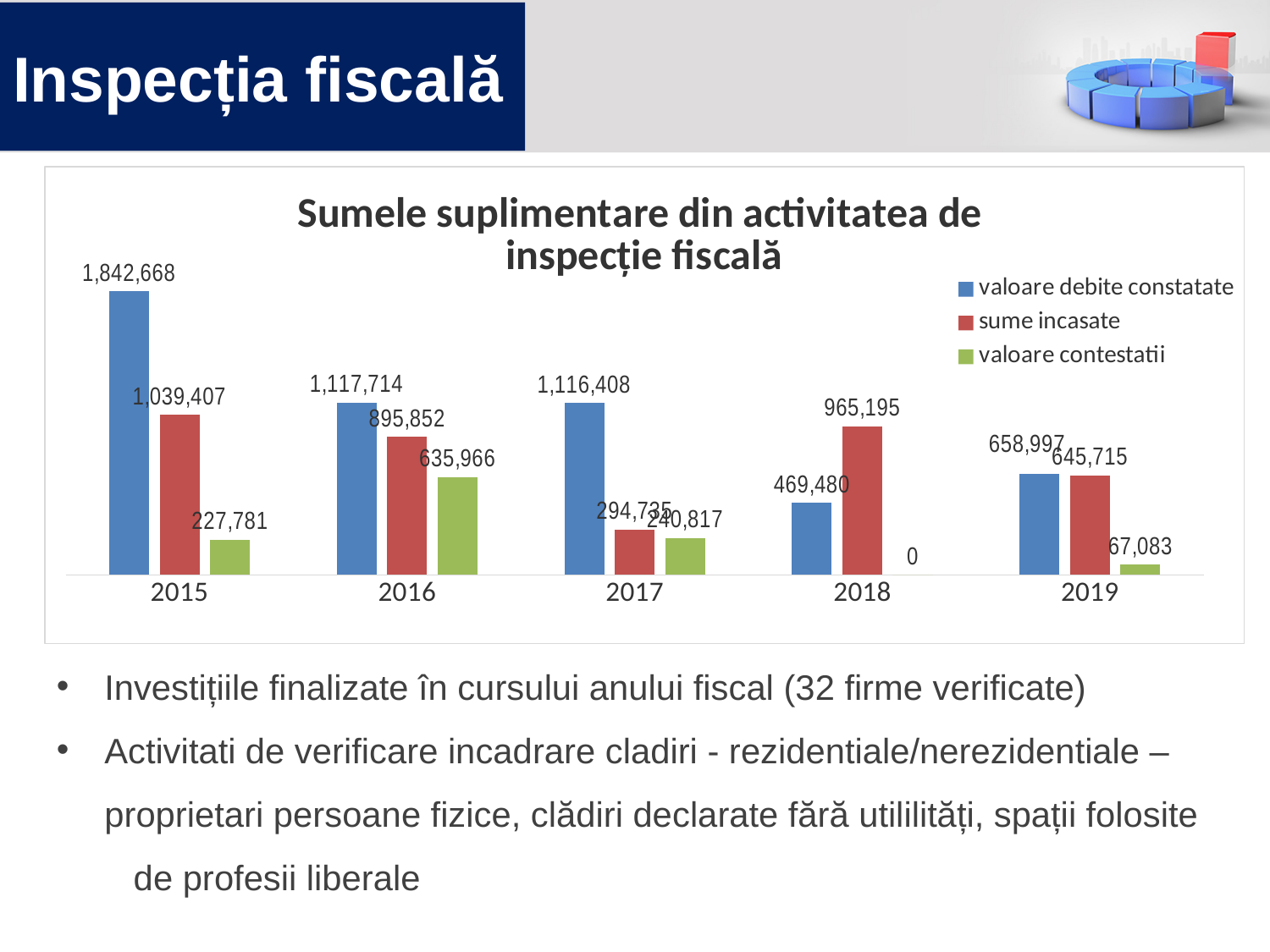
What is the value of 'valoare debite constatate' for 2015? 1,842,668 What is the value of 'valoare contestatii' for 2018? 0 How many years are shown on the x axis of the chart? 5 In which year is 'valoare contestatii' the lowest? 2018 What kind of chart is shown on the slide? bar chart What is the value of 'sume incasate' for 2016? 895,852 What is the value of 'valoare contestatii' for 2019? 67,083 How many series does the legend of the chart list? 3 In which year is 'valoare debite constatate' the highest? 2015 Does 'valoare debite constatate' rise or fall from 2015 to 2017? fall In 2018, which is larger: 'valoare debite constatate' or 'sume incasate'? sume incasate What is the difference between 'valoare debite constatate' and 'sume incasate' in 2015? 803,261